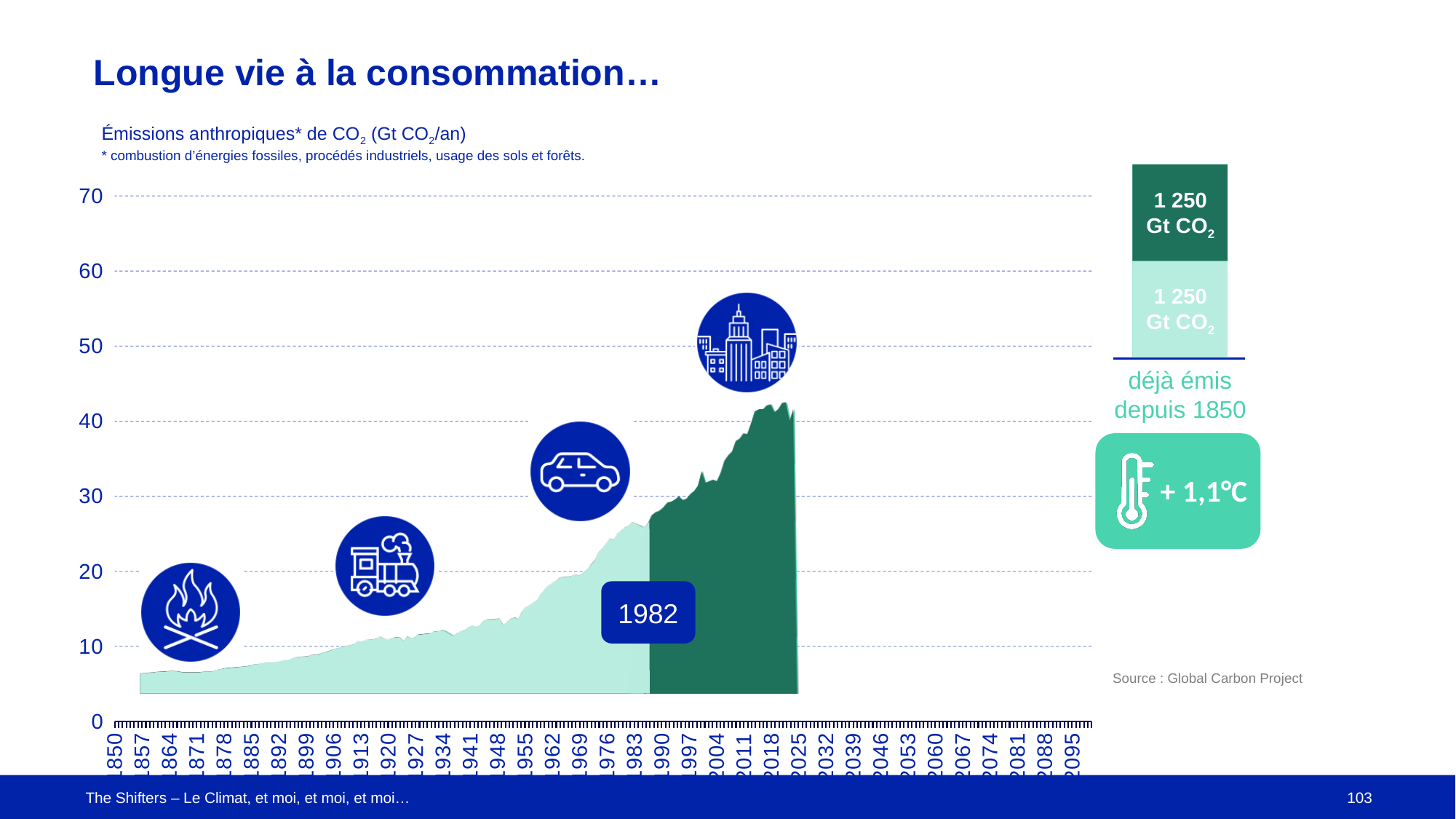
In the main chart, is the emissions value around 2020 greater or less than 30? greater What kind of chart is the main chart showing CO2 emissions over time? area chart What is the total of the two segments in the stacked bar on the right? 2 500 Gt CO2 What is the highest value shown on the y axis of the main chart? 70 Do the anthropogenic CO2 emissions rise or fall from 1850 to around 2020 in the main chart? rise In the stacked bar on the right, what value is shown in the dark green top segment? 1 250 Gt CO2 In the main chart, is the emissions value around 1950 greater or less than 20? less In the main chart, is the emissions value at 1982 greater or less than 20? greater What year is highlighted in the blue label on the main chart? 1982 How many segments does the stacked bar on the right have? 2 In the stacked bar on the right, what value is shown for the amount already emitted since 1850? 1 250 Gt CO2